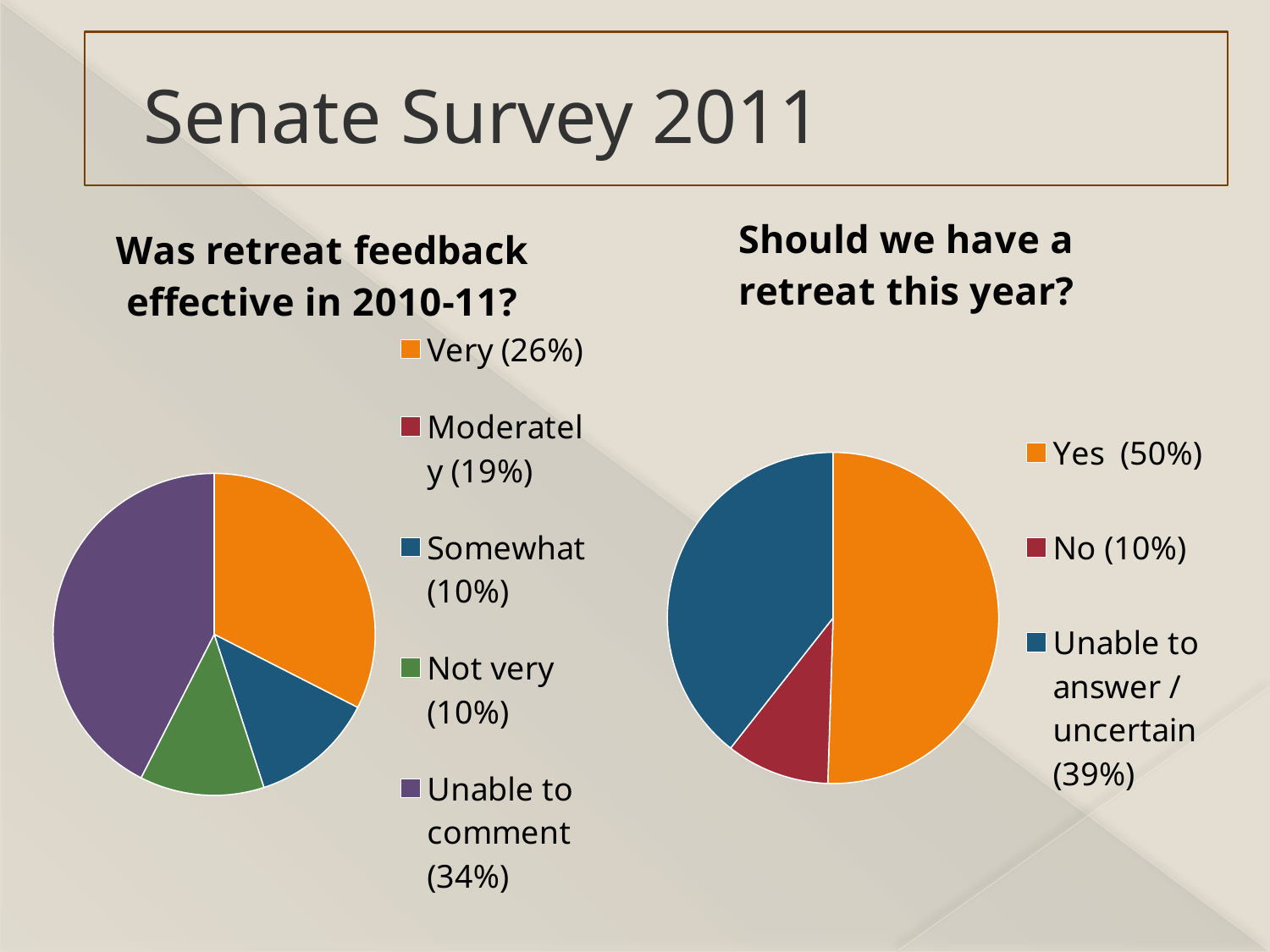
What kind of chart is the chart titled 'Should we have a retreat this year?'? Pie chart In the chart titled 'Should we have a retreat this year?', which category has the smallest share? No In the chart titled 'Was retreat feedback effective in 2010-11?', which category has the largest share? Unable to comment In the chart titled 'Should we have a retreat this year?', what colour is the 'Yes' slice? Orange In the chart titled 'Was retreat feedback effective in 2010-11?', how many categories does the legend list? 5 In the chart titled 'Was retreat feedback effective in 2010-11?', what is the difference between the 'Very' share and the 'Moderately' share? 7% In the chart titled 'Should we have a retreat this year?', how many categories does the legend list? 3 In the chart titled 'Should we have a retreat this year?', what share of responses is 'Yes'? 50% In the chart titled 'Was retreat feedback effective in 2010-11?', what share of responses is 'Unable to comment'? 34% In the chart titled 'Was retreat feedback effective in 2010-11?', what share of responses is 'Very'? 26% In the chart titled 'Was retreat feedback effective in 2010-11?', which is larger, 'Very' or 'Moderately'? Very